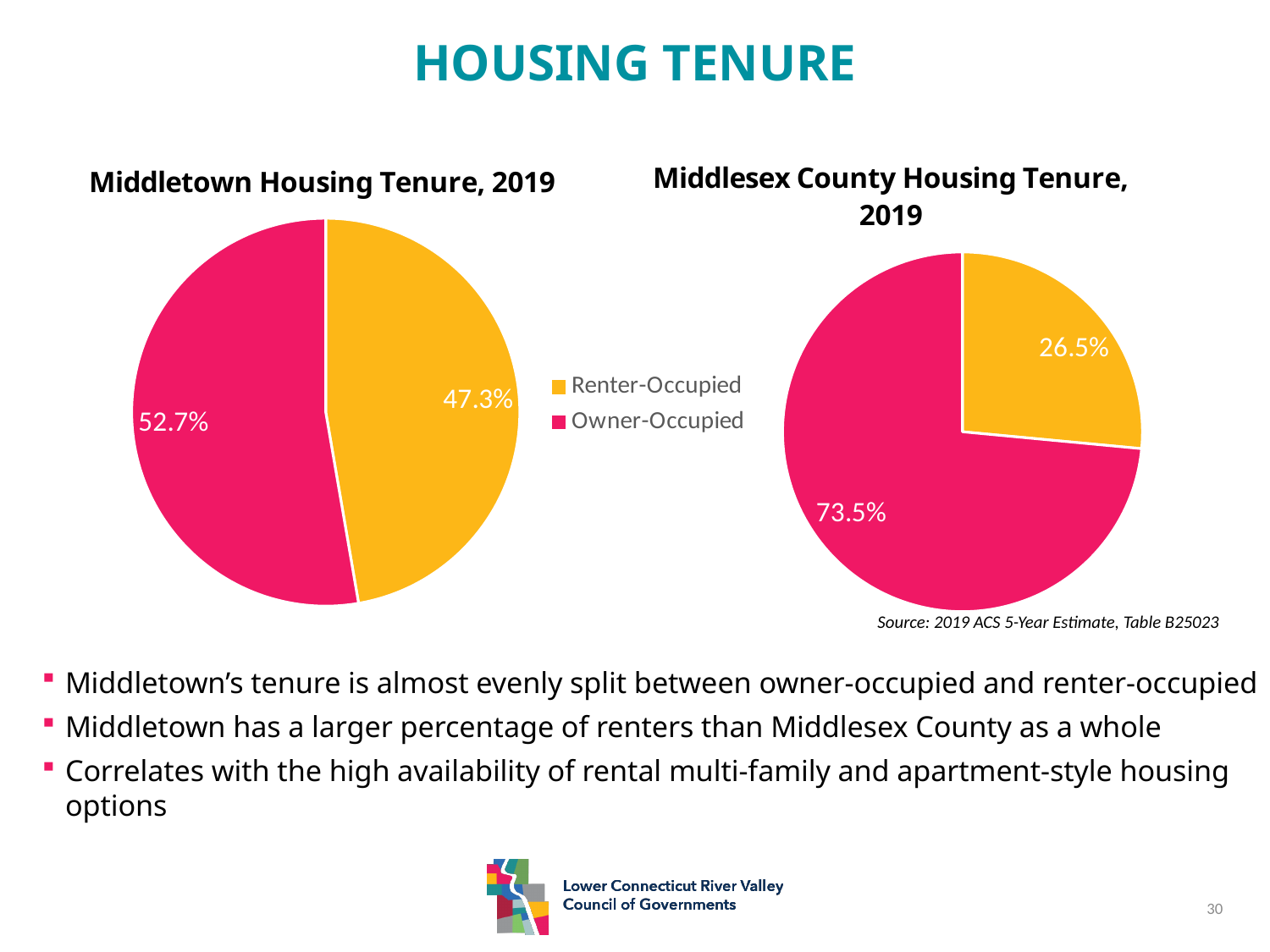
In the Middlesex County Housing Tenure, 2019 chart, what percentage is Renter-Occupied? 26.5% In the Middlesex County Housing Tenure, 2019 chart, what is the difference between the Owner-Occupied and Renter-Occupied shares? 47.0 percentage points In the Middlesex County Housing Tenure, 2019 chart, what percentage is Owner-Occupied? 73.5% What type of chart is the Middletown Housing Tenure, 2019 chart? Pie chart In the Middlesex County Housing Tenure, 2019 chart, which category has the largest share? Owner-Occupied In the Middletown Housing Tenure, 2019 chart, which category has the smallest share? Renter-Occupied In the Middletown Housing Tenure, 2019 chart, what percentage is Owner-Occupied? 52.7% Which chart shows a larger Renter-Occupied share, Middletown or Middlesex County? Middletown How many categories does the Middlesex County Housing Tenure, 2019 pie chart have? 2 How many entries does the shared legend list? 2 In the legend, which colour represents Owner-Occupied? Pink In the Middletown Housing Tenure, 2019 chart, what percentage is Renter-Occupied? 47.3%